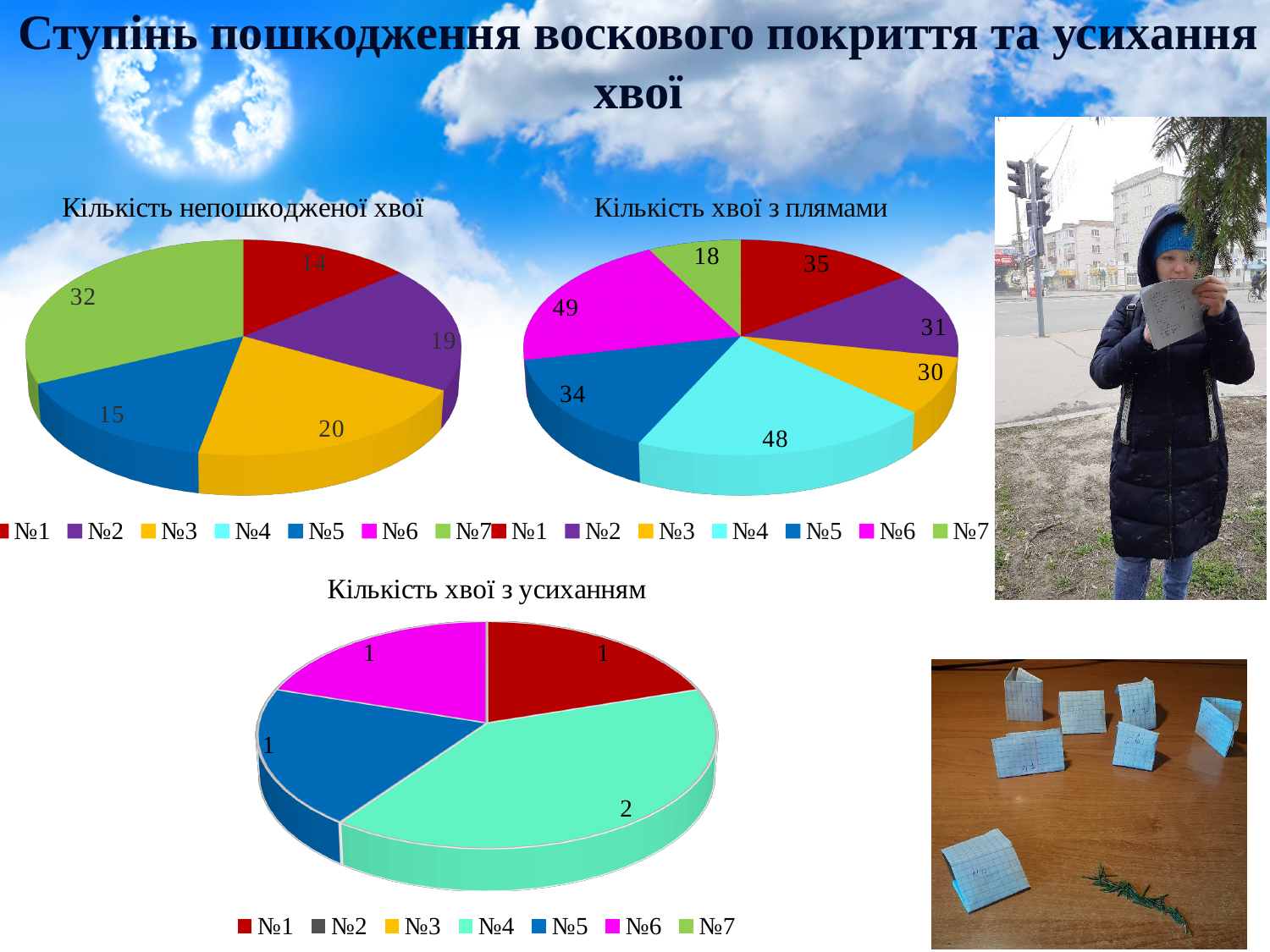
In the chart "Кількість непошкодженої хвої", what is the value for №7? 32 In the chart "Кількість хвої з плямами", what is the difference between the values for №6 and №7? 31 In the chart "Кількість хвої з плямами", which category has the smallest slice? №7 In the chart "Кількість непошкодженої хвої", what share of the total does №7 represent? 32% What kind of chart is "Кількість хвої з плямами"? pie chart In the chart "Кількість непошкодженої хвої", which category has the largest slice? №7 In the chart "Кількість хвої з плямами", what is the value for №4? 48 How many slices does the chart "Кількість хвої з усиханням" have? 4 How many entries does the legend of the chart "Кількість хвої з усиханням" list? 7 In the chart "Кількість хвої з усиханням", what is the value for №4? 2 In the chart "Кількість непошкодженої хвої", which is larger, the value for №3 or the value for №5? №3 What is the title of the pie chart at the bottom of the slide? Кількість хвої з усиханням